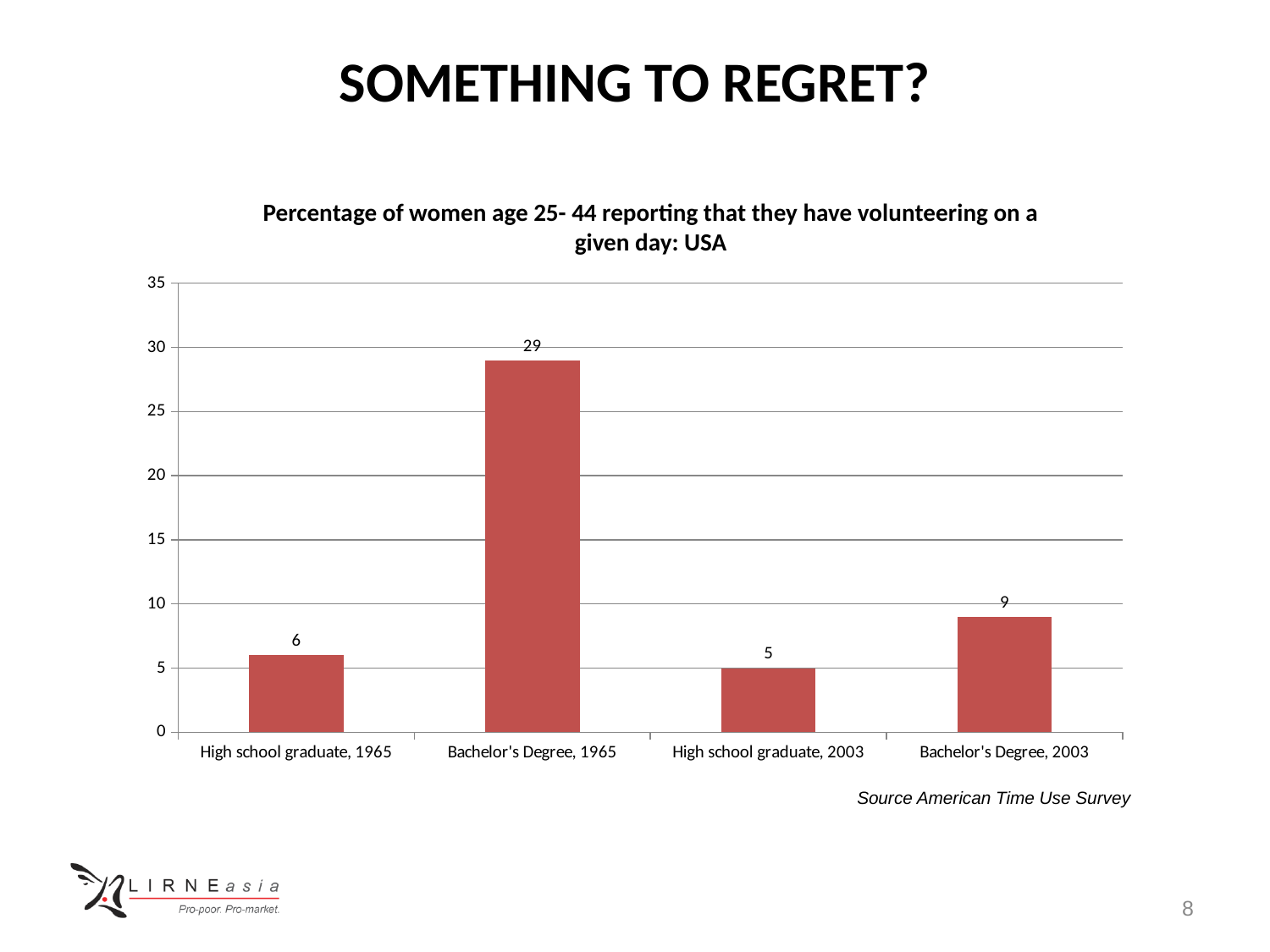
What is the value for Bachelor's Degree, 2003? 9 Is the value for Bachelor's Degree, 1965 greater or less than 25? greater Which category has the highest value? Bachelor's Degree, 1965 What is the title of the chart? Percentage of women age 25- 44 reporting that they have volunteering on a given day: USA What kind of chart is shown on the slide? Bar chart What is the value for High school graduate, 2003? 5 How many categories are shown on the x axis? 4 What is the difference between the values for Bachelor's Degree, 1965 and Bachelor's Degree, 2003? 20 What is the value for Bachelor's Degree, 1965? 29 What source is cited below the chart? American Time Use Survey Which category has the lowest value? High school graduate, 2003 Which is larger, the value for High school graduate, 1965 or High school graduate, 2003? High school graduate, 1965